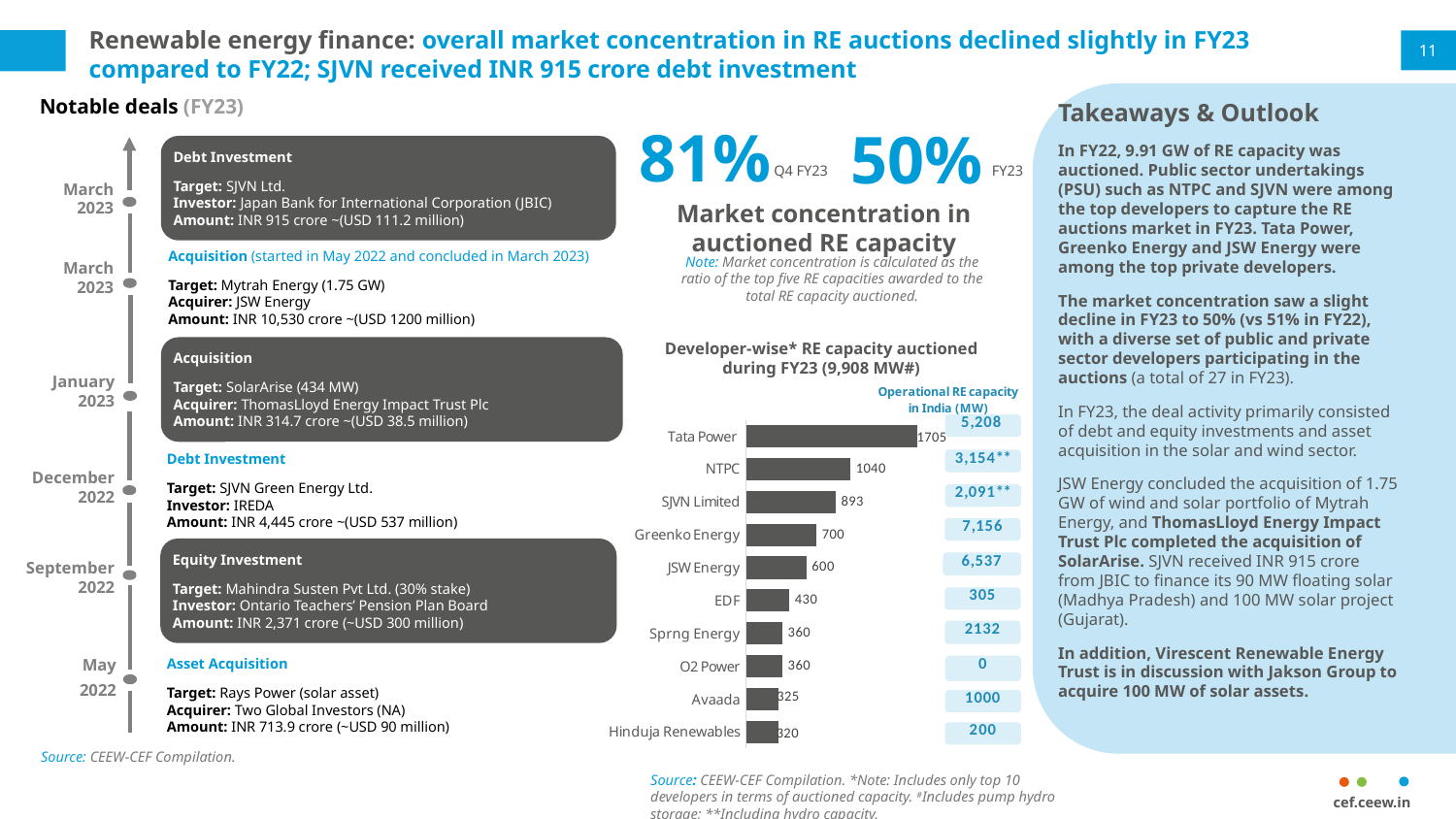
In the developer-wise RE capacity auctioned chart, what is the value for EDF? 430 In the column next to the chart, what is the operational RE capacity in India (MW) for Greenko Energy? 7,156 In the developer-wise RE capacity auctioned chart, which is larger: JSW Energy or Avaada? JSW Energy In the developer-wise RE capacity auctioned chart, what is the difference between Tata Power and NTPC? 665 In the developer-wise RE capacity auctioned chart, what is the difference between NTPC and Greenko Energy? 340 What type of chart is used to show developer-wise RE capacity auctioned during FY23? bar chart How many developers are shown in the developer-wise RE capacity auctioned chart? 10 What is the total auctioned capacity stated in the title of the developer-wise RE capacity chart? 9,908 MW Which developer has the highest RE capacity auctioned during FY23 in the chart? Tata Power In the developer-wise RE capacity auctioned chart, what is the value for SJVN Limited? 893 Which developer has the lowest RE capacity auctioned during FY23 in the chart? Hinduja Renewables In the developer-wise RE capacity auctioned chart, what is the value for Tata Power? 1705